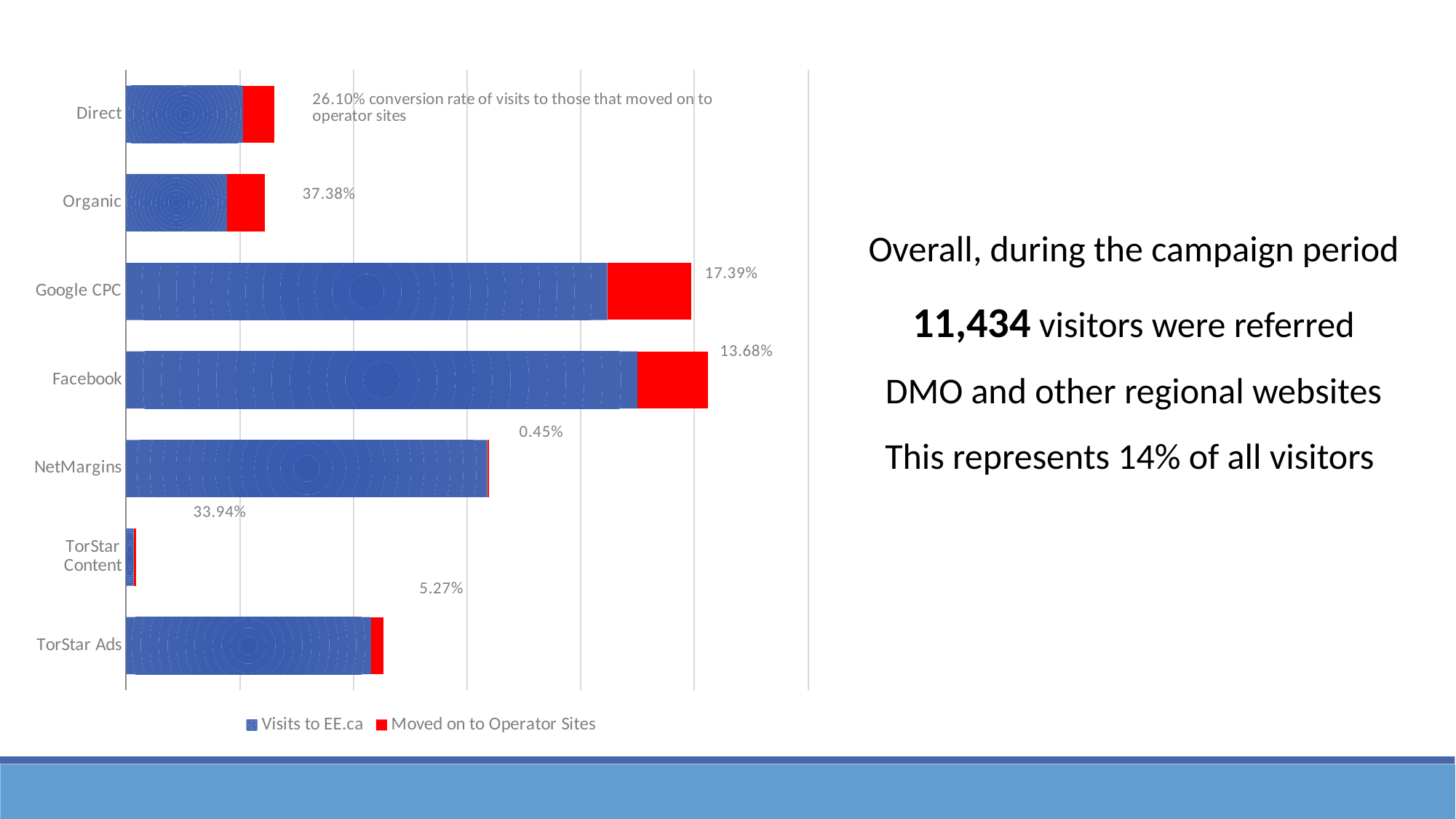
What conversion rate is labelled for the Organic category? 37.38% Which has a larger Moved on to Operator Sites segment, Direct or TorStar Ads? Direct Which has more Visits to EE.ca, Google CPC or Direct? Google CPC How many traffic source categories are plotted on the chart? 7 What conversion rate is labelled for Google CPC? 17.39% What conversion rate is labelled for Facebook? 13.68% Which colour represents the Moved on to Operator Sites series in the legend? Red What kind of chart is shown on the slide? Stacked bar chart What is the difference between the Organic and Direct conversion rates labelled on the chart? 11.28 percentage points How many series does the chart legend list? 2 Which category has the shortest total bar on the chart? TorStar Content What conversion rate is labelled for the Direct category? 26.10%